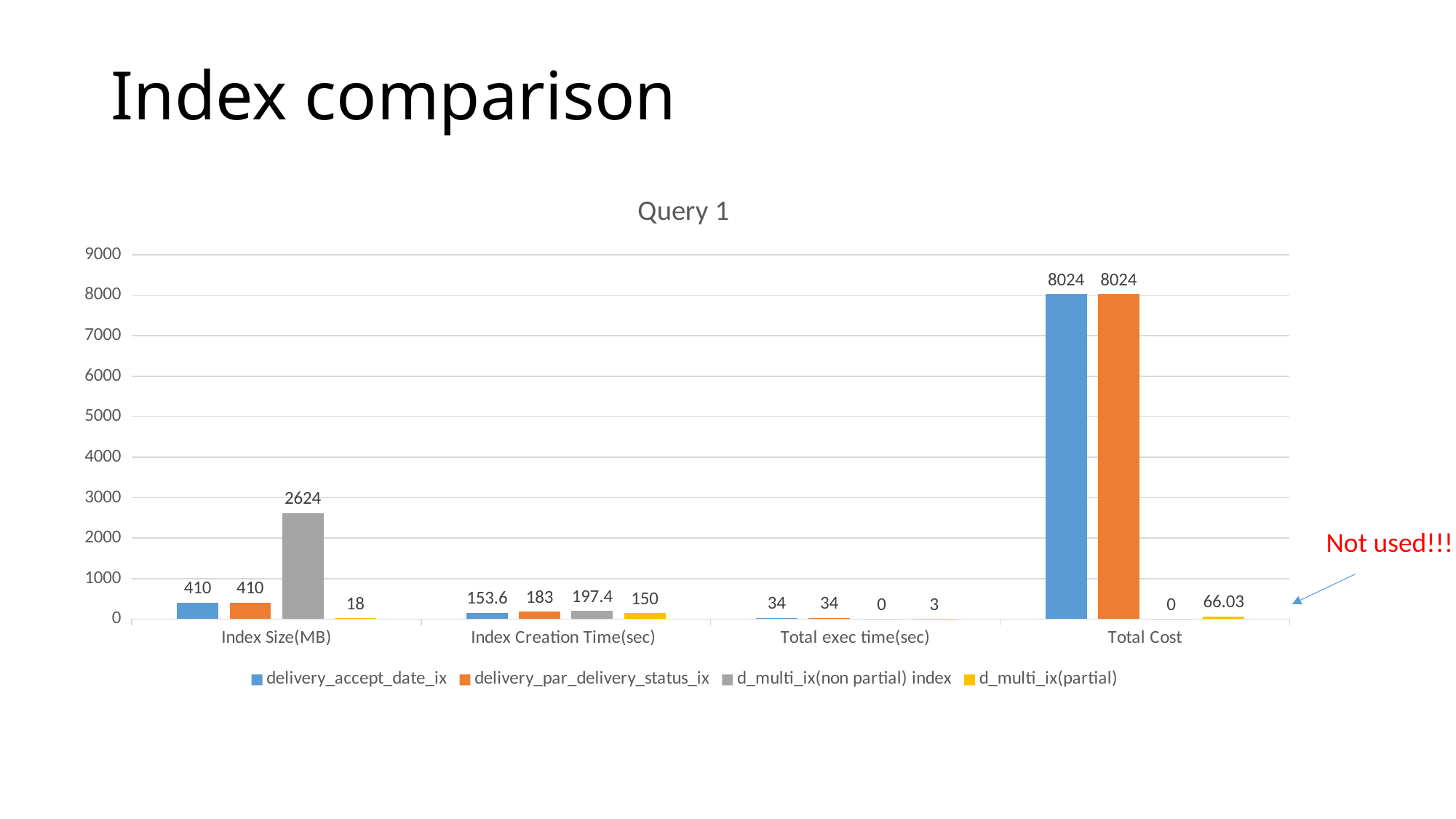
Which series has the highest Index Size(MB)? d_multi_ix(non partial) index What is the difference between the Index Size(MB) of d_multi_ix(non partial) index and d_multi_ix(partial)? 2606 What is the Index Creation Time(sec) value for delivery_par_delivery_status_ix? 183 What type of chart is shown on the slide? Bar chart How many categories are shown on the x axis? 4 Which is larger: the Index Creation Time(sec) for d_multi_ix(non partial) index or for delivery_accept_date_ix? d_multi_ix(non partial) index How many series does the legend list? 4 Which series has the lowest Index Creation Time(sec)? d_multi_ix(partial) What is the Total exec time(sec) value for d_multi_ix(partial)? 3 What is the Index Size(MB) value for d_multi_ix(non partial) index? 2624 Is the Total Cost value for delivery_accept_date_ix greater or less than 7000? greater What is the Total Cost value for d_multi_ix(partial)? 66.03